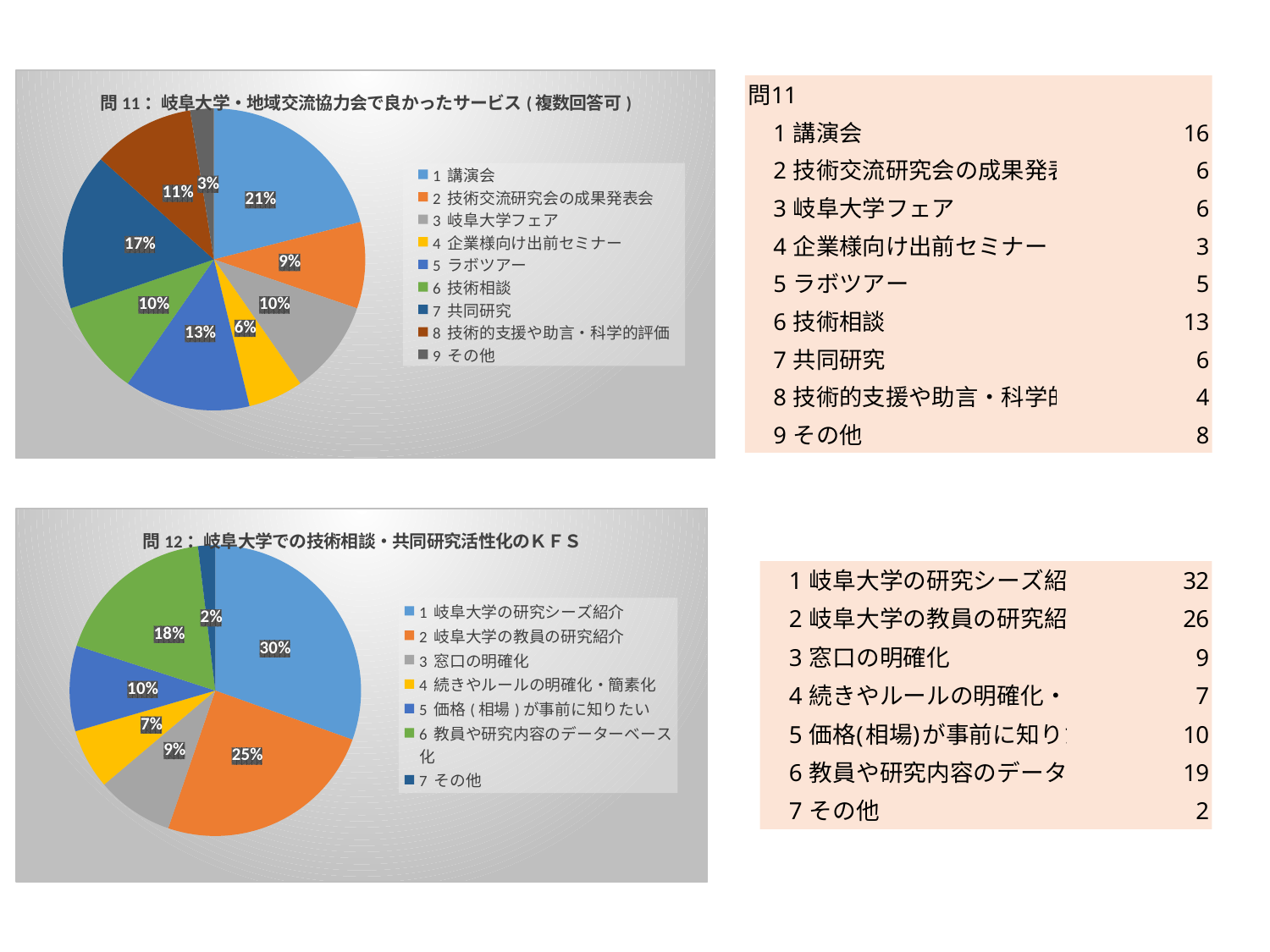
In the bottom pie chart (問12), how many categories does the legend list? 7 In the bottom pie chart (問12), what percentage is shown for 7 その他? 2% In the bottom pie chart (問12), which category has the largest share? 1 岐阜大学の研究シーズ紹介 What kind of chart is the bottom chart (問12)? Pie chart In the top pie chart (問11), which category has the largest share? 1 講演会 In the bottom pie chart (問12), what percentage is shown for 2 岐阜大学の教員の研究紹介? 25% In the top pie chart (問11), what is the difference in percentage points between 5 ラボツアー and 4 企業様向け出前セミナー? 7 In the top pie chart (問11), what percentage is shown for 1 講演会? 21% In the top pie chart (問11), what percentage is shown for 7 共同研究? 17% In the top pie chart (問11), which category has the smallest share? 9 その他 In the bottom pie chart (問12), which is larger: 6 教員や研究内容のデーターベース化 or 5 価格(相場)が事前に知りたい? 6 教員や研究内容のデーターベース化 In the top pie chart (問11), how many categories does the legend list? 9